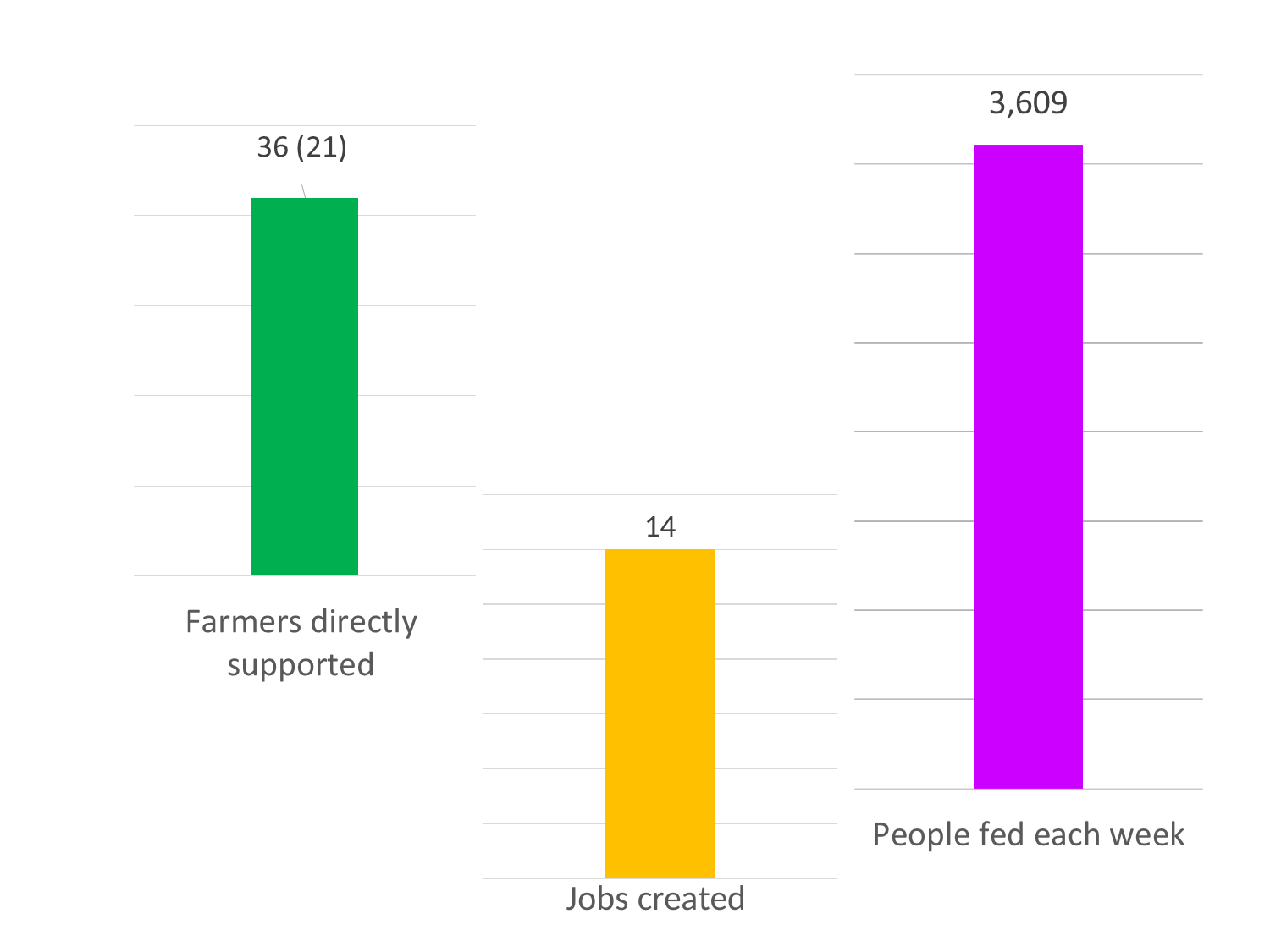
What colour is the bar in the left chart for Farmers directly supported? green Which is larger, the value for People fed each week on the right chart or the value for Jobs created on the middle chart? People fed each week Across the three charts, which category has the lowest labelled value? Jobs created On the right chart, what is the value shown for People fed each week? 3,609 What colour is the bar in the right chart for People fed each week? magenta What is the difference between the People fed each week value (right chart) and the Jobs created value (middle chart)? 3,595 What kind of chart is used for the Jobs created figure in the middle of the slide? bar chart On the middle chart, what is the value shown for Jobs created? 14 Across the three charts, which category has the highest labelled value? People fed each week How many bars does the right chart, People fed each week, contain? 1 How many separate charts are shown on the slide? 3 On the left chart, what is the data label shown on the bar for Farmers directly supported? 36 (21)